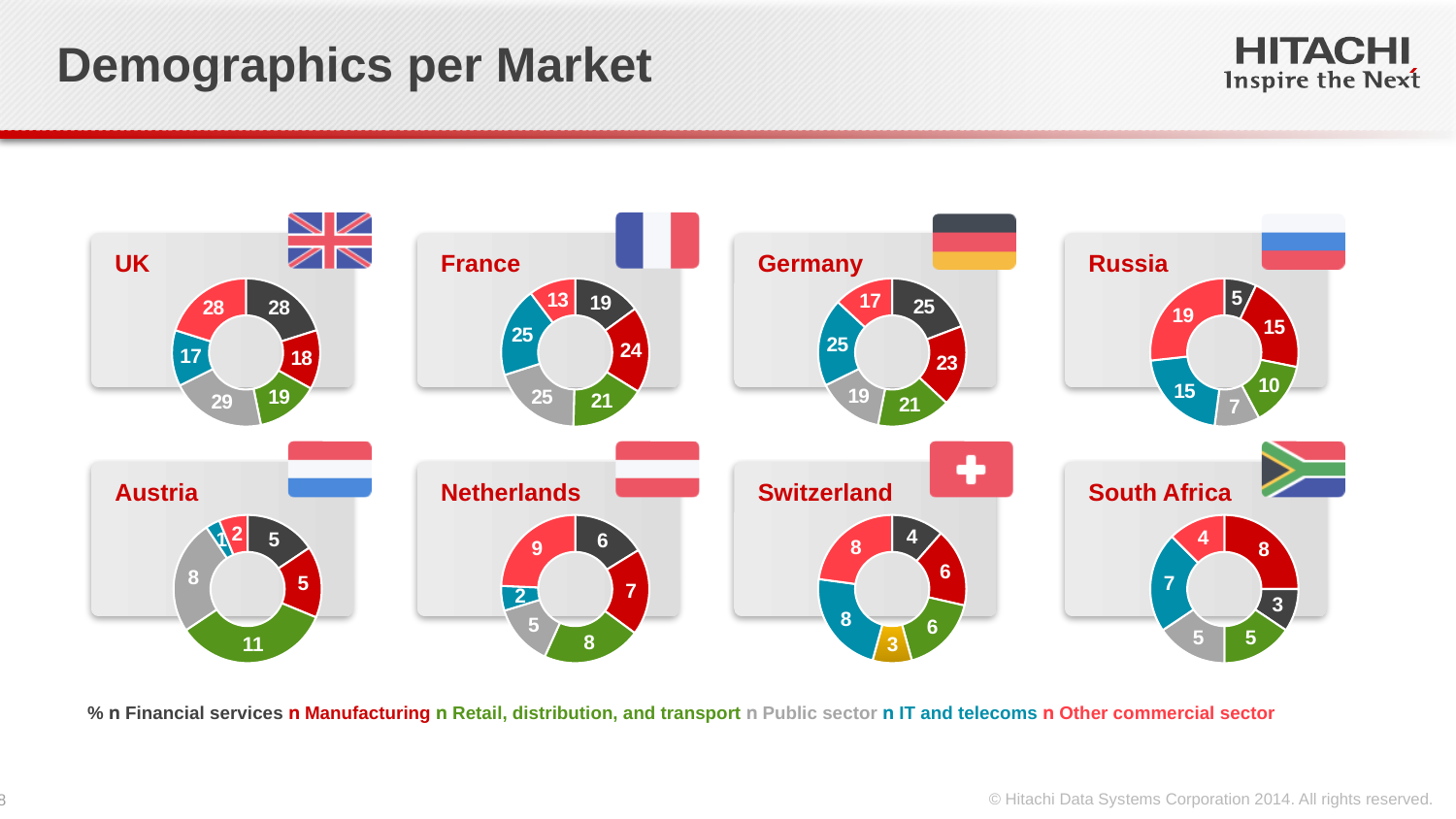
In the Germany chart, what is the value for Other commercial sector? 17 How many market charts are shown on the slide? 8 What kind of chart is used for each market on the slide? Donut (pie) chart In the South Africa chart, what is the difference between Manufacturing and Financial services? 5 In the Austria chart, which sector has the highest value? Retail, distribution, and transport In the Germany chart, which is larger: Manufacturing or Public sector? Manufacturing In the Netherlands chart, which sector has the lowest value? IT and telecoms How many sectors does the legend list? 6 In the Switzerland chart, what is the value for IT and telecoms? 8 In the Russia chart, which sector has the highest value? Other commercial sector In the UK chart, what is the value for Public sector? 29 In the France chart, what is the value for Manufacturing? 24